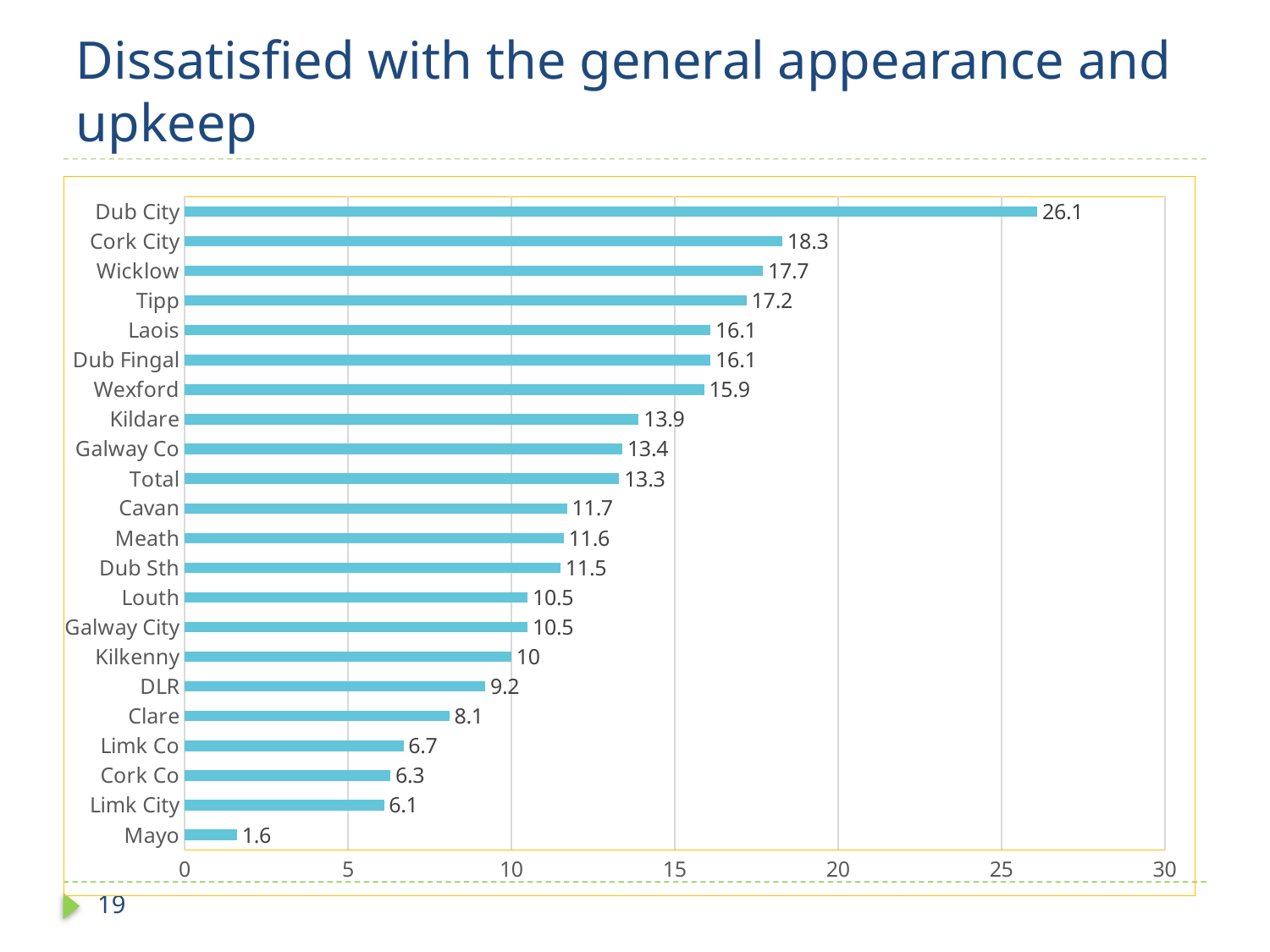
What is the difference between the values for Dub City and Cork City? 7.8 What is the value for Kilkenny? 10 How many categories are shown on the chart? 22 What is the value for Total? 13.3 Which is larger, the value for Wicklow or the value for Kildare? Wicklow Which category has the highest value? Dub City What kind of chart is shown on the slide? bar chart Is the value for Laois greater or less than 15? greater What is the title of the slide? Dissatisfied with the general appearance and upkeep Which category has the lowest value? Mayo What is the value for Dub City? 26.1 What is the value for Mayo? 1.6